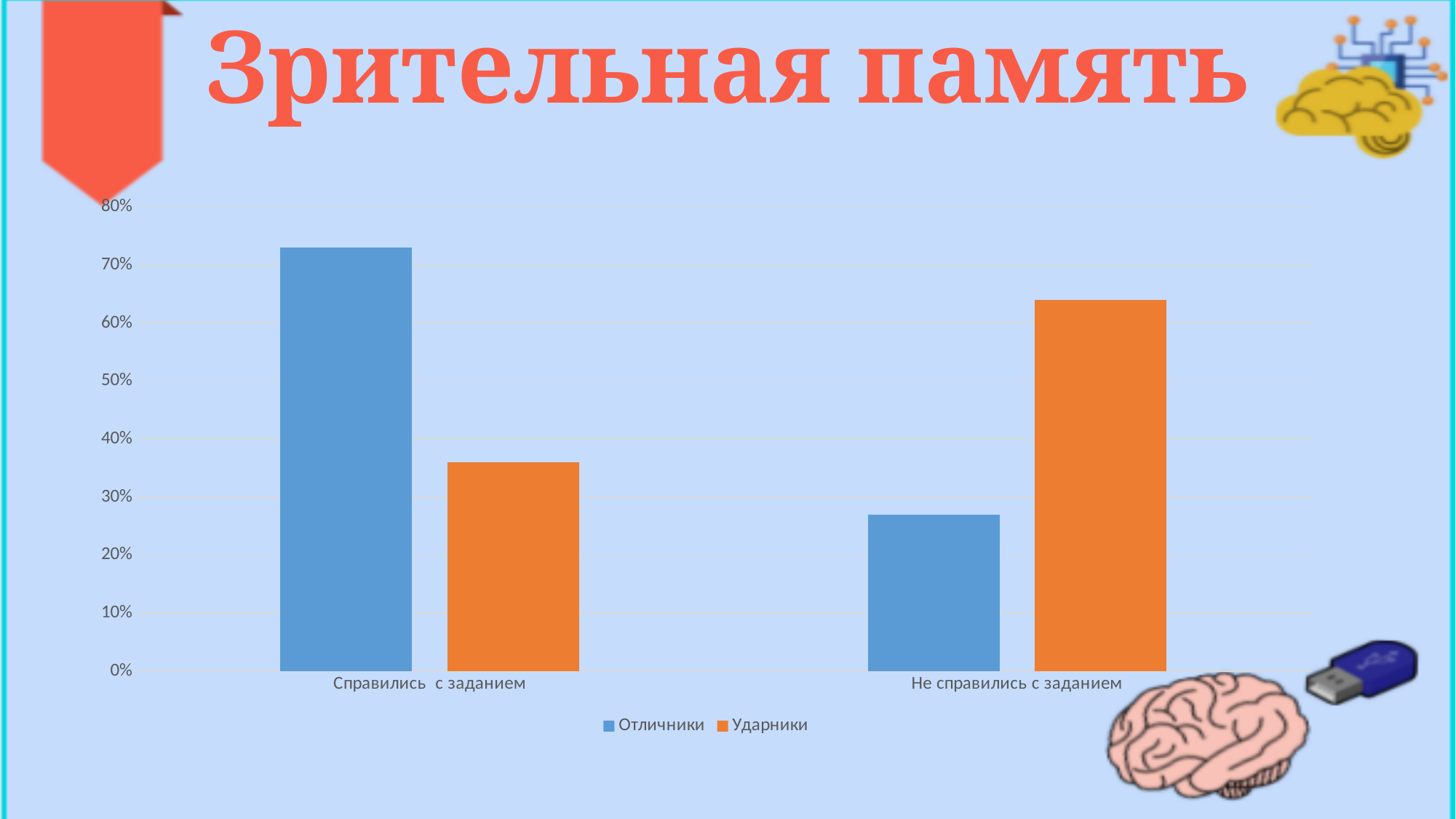
Is the value for Отличники in the category 'Не справились с заданием' greater or less than 30%? less In the category 'Справились с заданием', which series has the larger value, Отличники or Ударники? Отличники How many series does the legend list? 2 What is the title of the slide containing the chart? Зрительная память How many categories are shown on the x axis? 2 Is the value for Отличники in the category 'Справились с заданием' greater or less than 70%? greater Is the value for Ударники in the category 'Справились с заданием' greater or less than 40%? less Which bar is the tallest in the chart? Отличники, Справились с заданием Which series does the blue colour represent in the legend? Отличники In the category 'Не справились с заданием', which series has the larger value, Отличники or Ударники? Ударники What kind of chart is shown on the slide? bar chart